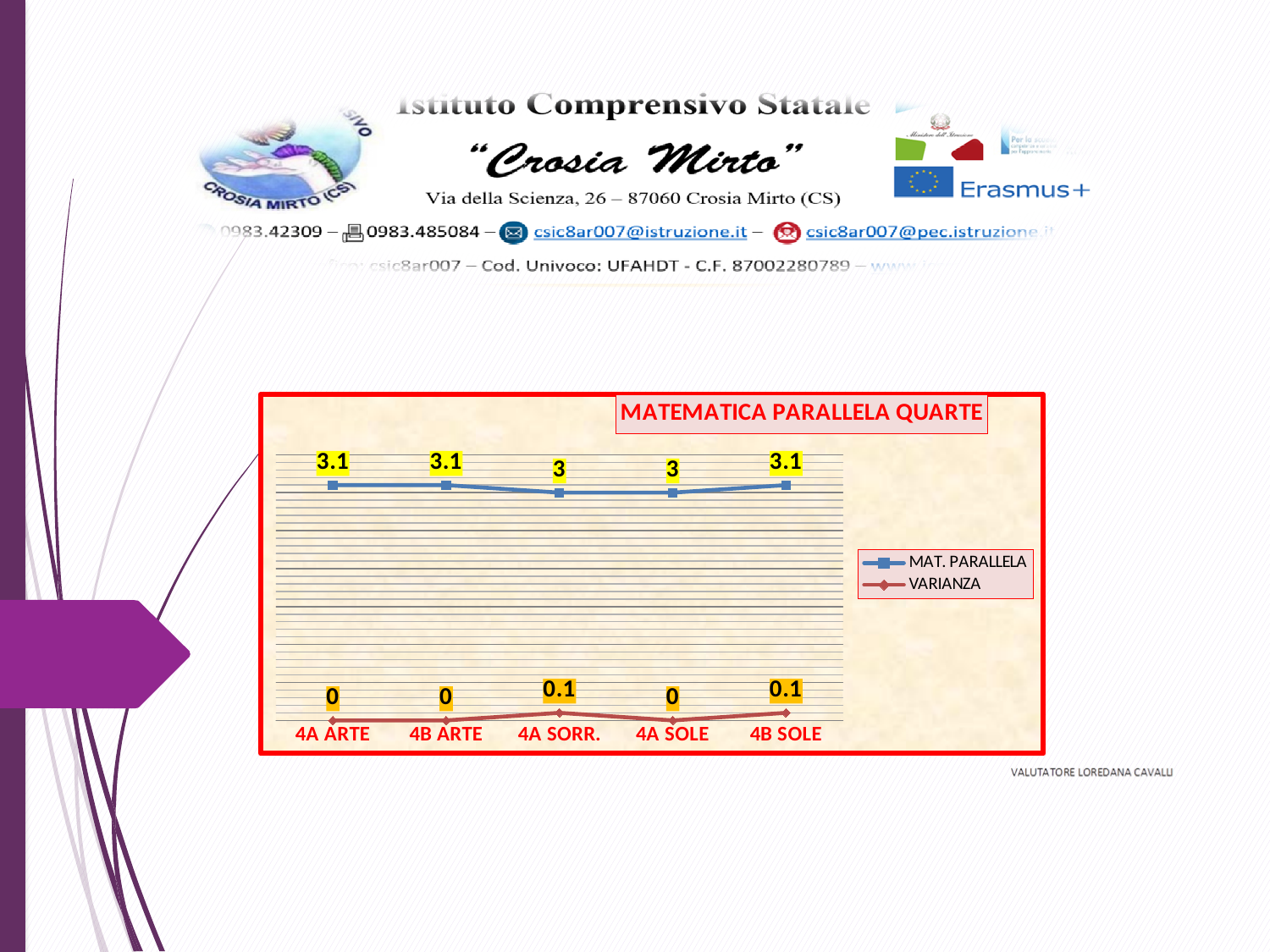
Which category has the lowest VARIANZA value that is not zero? 4A SORR. and 4B SOLE (both 0.1) What kind of chart is shown on the slide? Line chart What is the VARIANZA value for 4A ARTE? 0 How many categories are shown on the x axis? 5 Which series is drawn in red? VARIANZA Which is larger, the MAT. PARALLELA value for 4B SOLE or for 4A SOLE? 4B SOLE What is the MAT. PARALLELA value for 4A SORR.? 3 What is the VARIANZA value for 4B SOLE? 0.1 How many series does the legend list? 2 What is the title of the chart? MATEMATICA PARALLELA QUARTE What is the difference between the MAT. PARALLELA values for 4A ARTE and 4A SOLE? 0.1 What is the MAT. PARALLELA value for 4B ARTE? 3.1